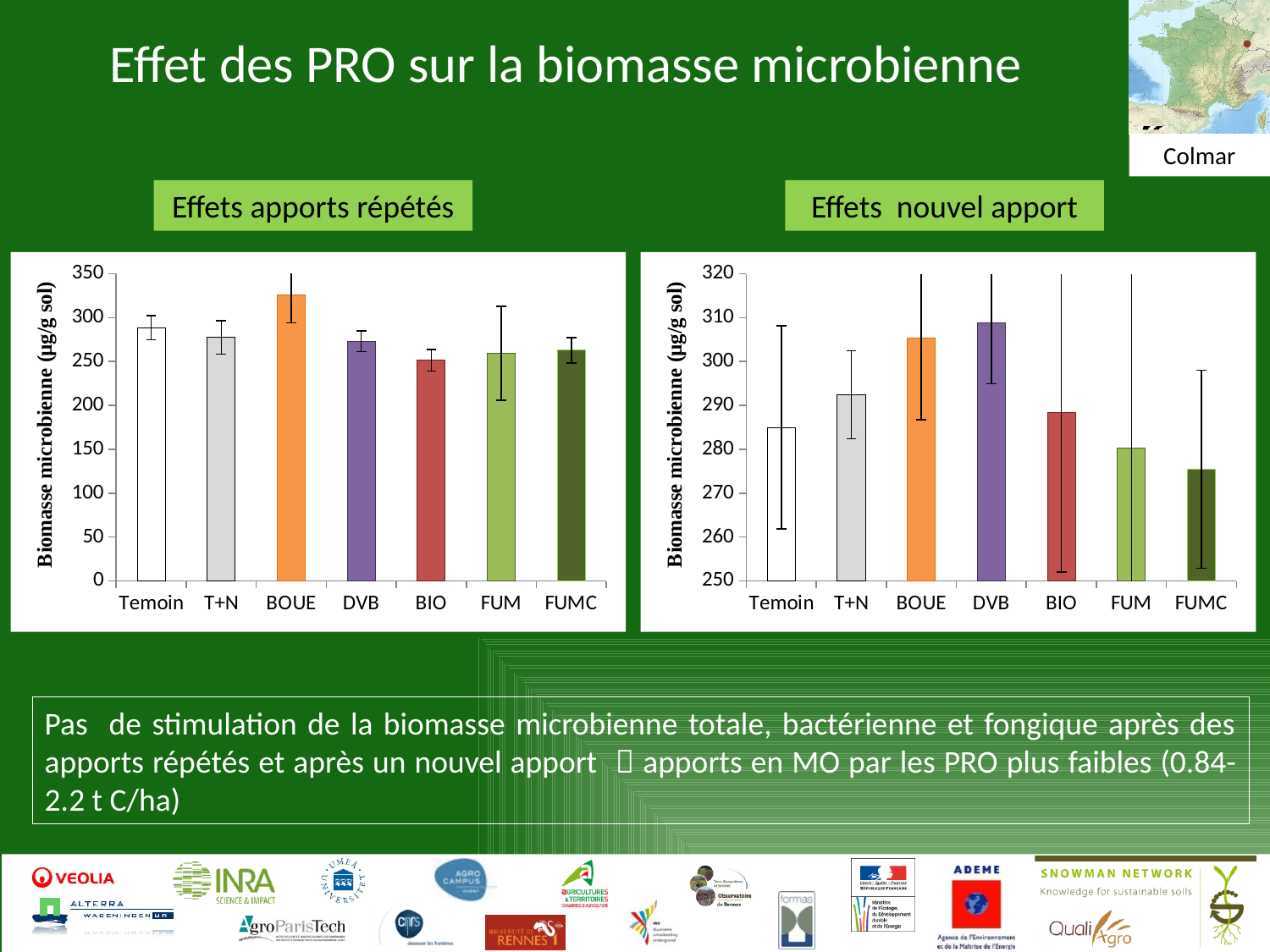
In the 'Effets apports répétés' chart on the left, which is larger, the value for BOUE or the value for BIO? BOUE In the 'Effets nouvel apport' chart on the right, is the value for FUMC greater or less than 280? less What kind of chart is the 'Effets apports répétés' chart on the left? bar chart What is the title shown above the chart on the right? Effets nouvel apport In the 'Effets apports répétés' chart on the left, is the value for BOUE greater or less than 300? greater In the 'Effets nouvel apport' chart on the right, is the value for DVB greater or less than 300? greater In the 'Effets nouvel apport' chart on the right, which is larger, the value for T+N or the value for FUMC? T+N In the 'Effets nouvel apport' chart on the right, which category has the lowest biomass value? FUMC How many categories are shown on the x axis of the 'Effets nouvel apport' chart on the right? 7 In the 'Effets apports répétés' chart on the left, which category has the highest biomass value? BOUE What is the y-axis label of the 'Effets apports répétés' chart on the left? Biomasse microbienne (µg/g sol)